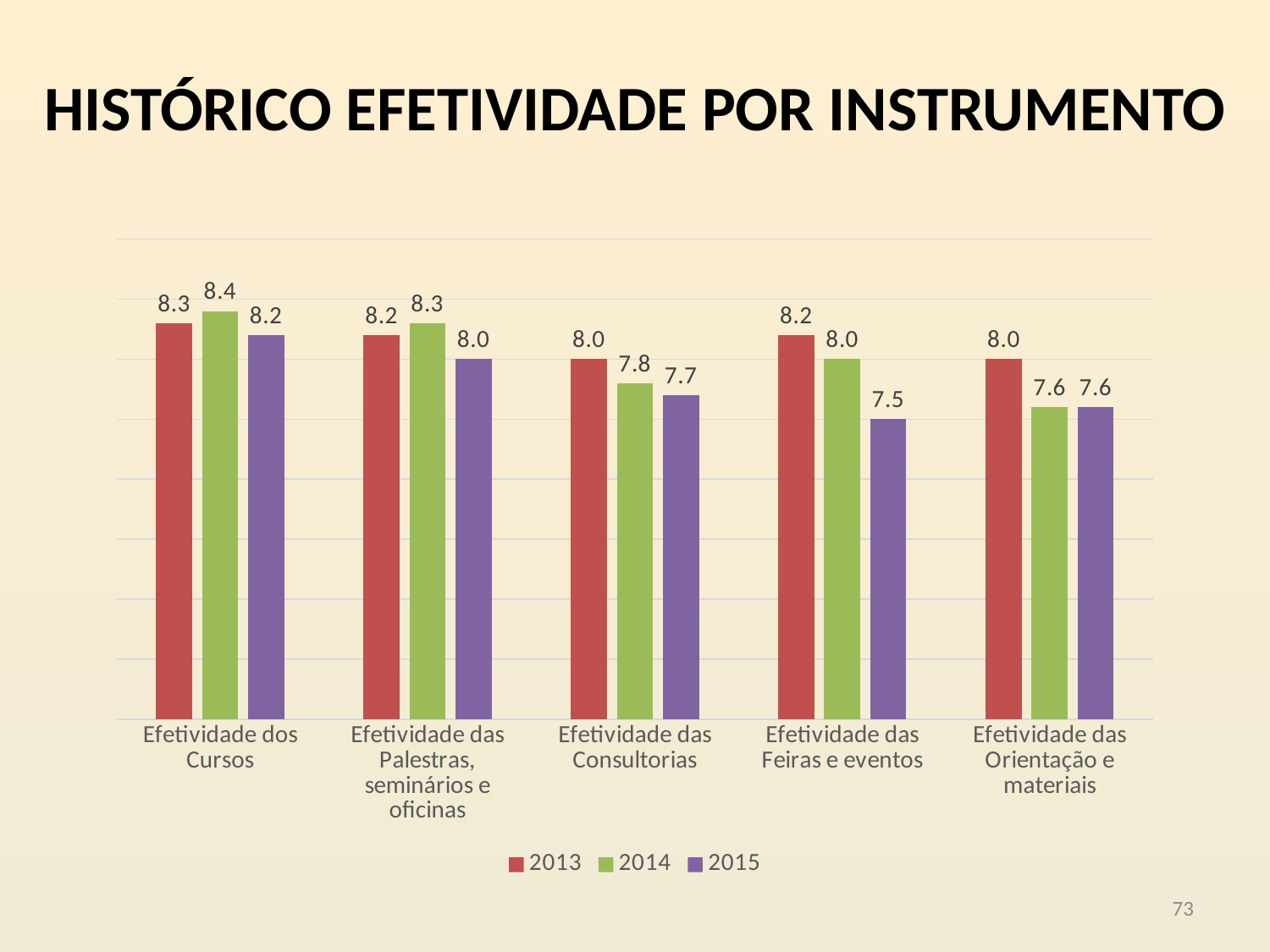
Which is larger: the 2014 value for Efetividade das Palestras, seminários e oficinas or the 2014 value for Efetividade das Consultorias? Efetividade das Palestras, seminários e oficinas What is the difference between the 2013 and 2015 values for Efetividade das Feiras e eventos? 0.7 What is the value for Efetividade das Feiras e eventos in 2015? 7.5 Which category has the lowest value in 2015? Efetividade das Feiras e eventos Which category has the highest value in 2014? Efetividade dos Cursos What is the value for Efetividade das Consultorias in 2013? 8.0 How many series does the legend list? 3 What kind of chart is shown on the slide? Bar chart What is the title of the slide? HISTÓRICO EFETIVIDADE POR INSTRUMENTO Do the values for Efetividade das Consultorias rise or fall from 2013 to 2015? Fall How many categories are shown on the x axis? 5 What is the value for Efetividade dos Cursos in 2014? 8.4